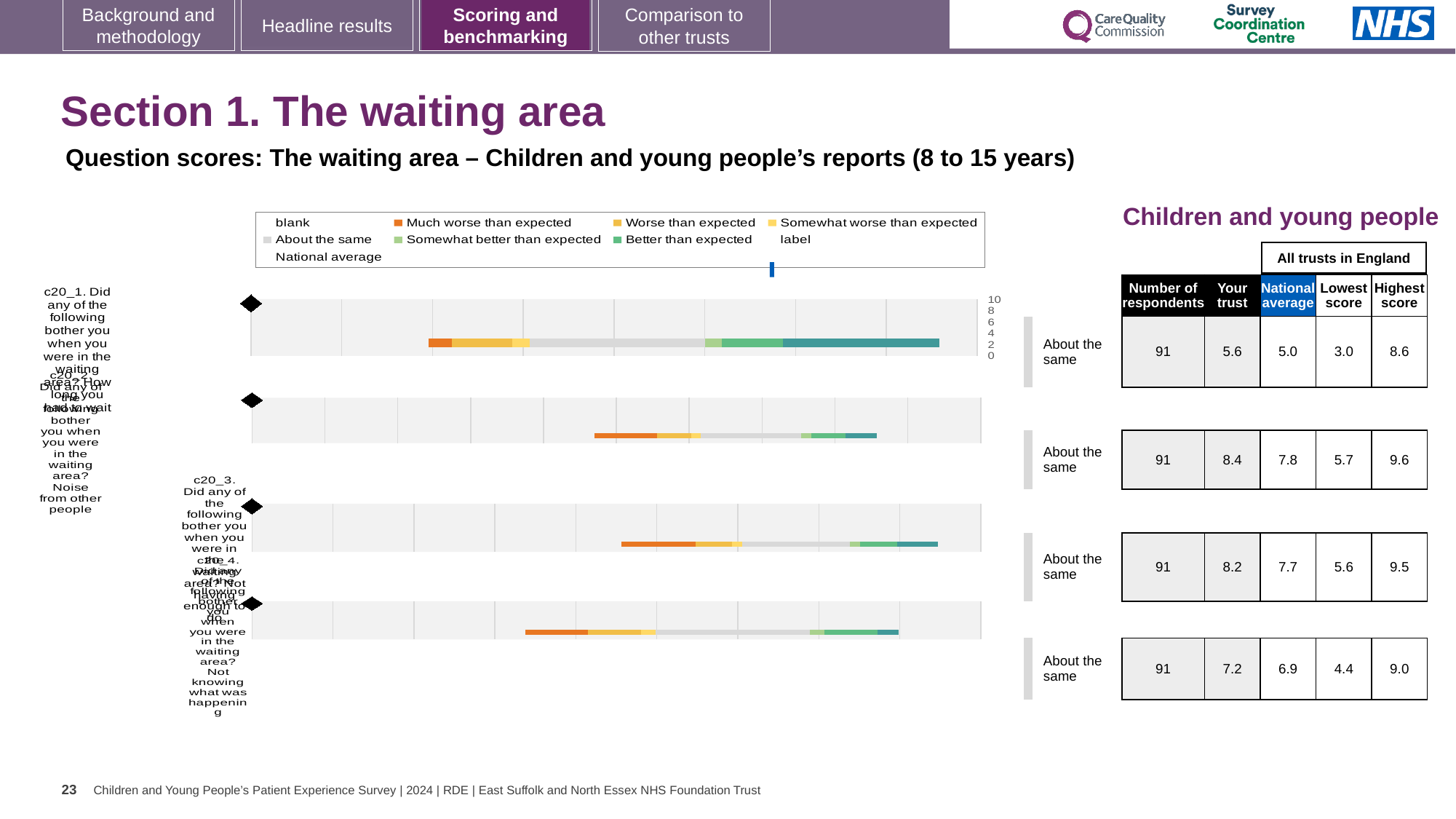
How many entries does the legend above the charts list? 9 What benchmark category is shown next to each of the four bars? About the same Which question has the lowest 'Your trust' score? c20_1 (Noise from other people) How many respondents are shown for c20_4 (Not knowing what was happening)? 91 What is the highest score across all trusts in England for c20_4 (Not knowing what was happening)? 9.0 For c20_2 (How long you had to wait), what is the difference between the 'Your trust' score and the national average? 0.6 How many waiting-area questions (bars) are plotted on the slide? 4 Which question has the highest 'Your trust' score? c20_2 (How long you had to wait) What is the national average score for c20_1 (Noise from other people)? 5.0 What is the 'Your trust' score for c20_2 (How long you had to wait)? 8.4 For c20_3 (Not having enough to do), which is larger: the 'Your trust' score or the national average? Your trust What kind of chart is used to show the question scores on this slide? bar chart